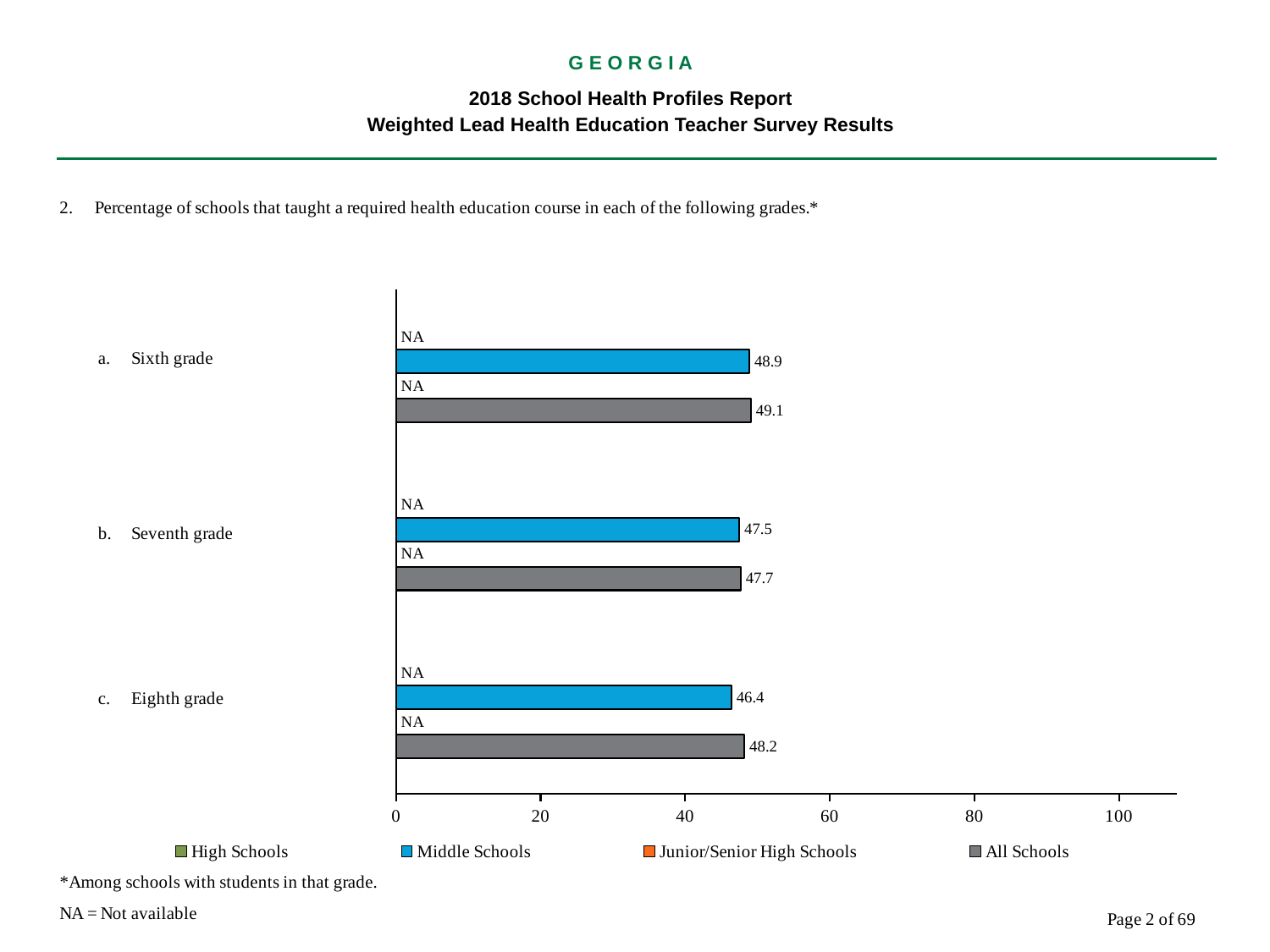
Which is larger in Eighth grade: the Middle Schools value or the All Schools value? All Schools Which grade has the lowest value for Middle Schools? Eighth grade How many series does the legend list? 4 What is the value for Middle Schools in Sixth grade? 48.9 Is the value for All Schools in Sixth grade greater or less than 60? less What is the value for All Schools in Eighth grade? 48.2 What is the value for All Schools in Seventh grade? 47.7 How many grade categories are shown on the chart? 3 What kind of chart is shown on the slide? bar chart What is the difference between the All Schools value and the Middle Schools value in Eighth grade? 1.8 Which grade has the highest value for Middle Schools? Sixth grade What is the value for Middle Schools in Seventh grade? 47.5